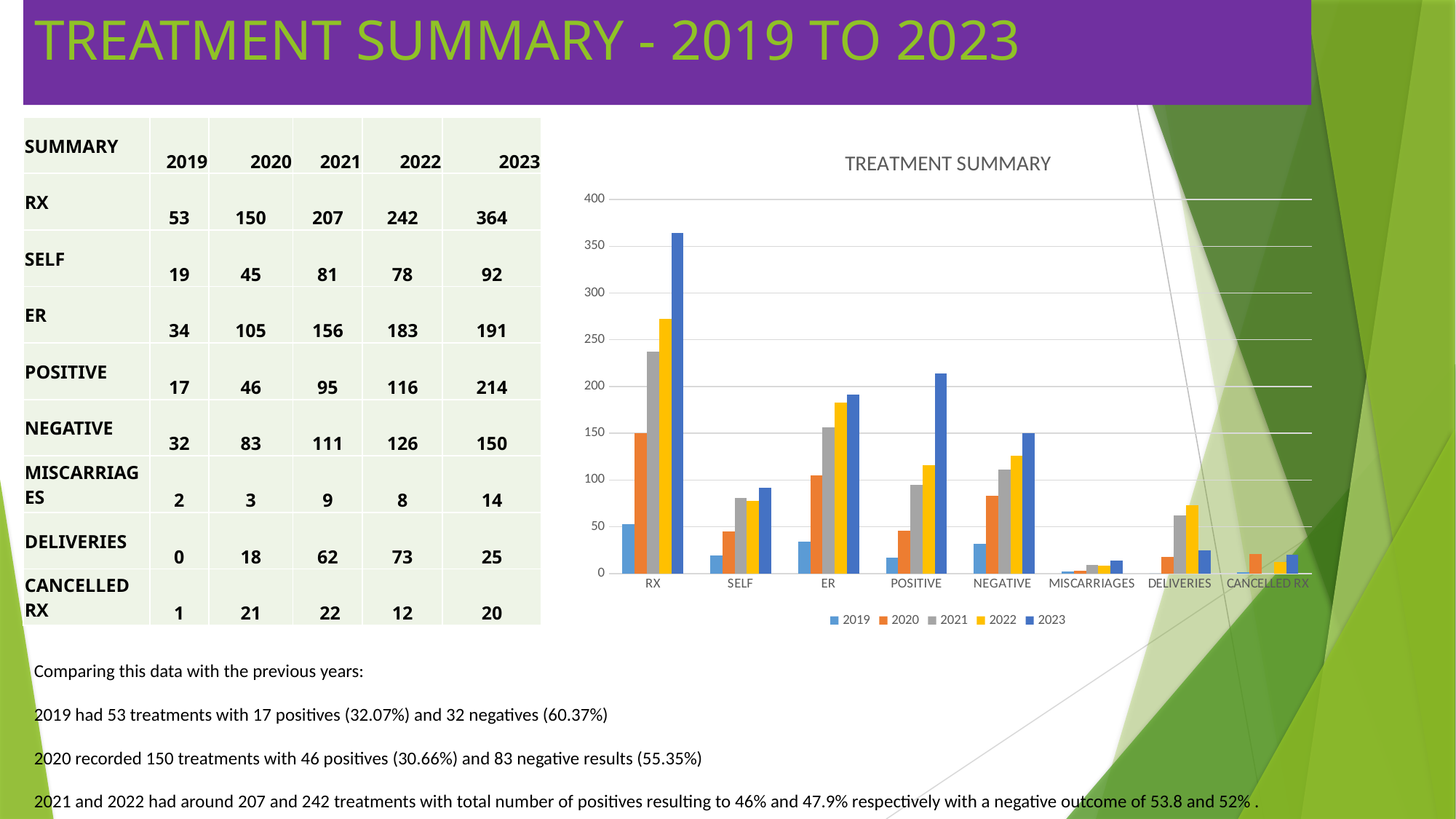
How many categories are shown along the x axis of the chart? 8 What is the difference between the POSITIVE values for 2023 and 2022? 98 Is the value for RX in 2023 greater or less than 350? greater Do the RX values rise or fall from 2019 to 2023? rise Is the value for ER in 2022 greater or less than 150? greater What is the value for RX in 2023? 364 How many series does the chart legend list? 5 Which is larger in 2023, POSITIVE or NEGATIVE? POSITIVE What kind of chart is shown on the slide? bar chart Which category has the tallest bar for 2023? RX What is the title of the chart? TREATMENT SUMMARY